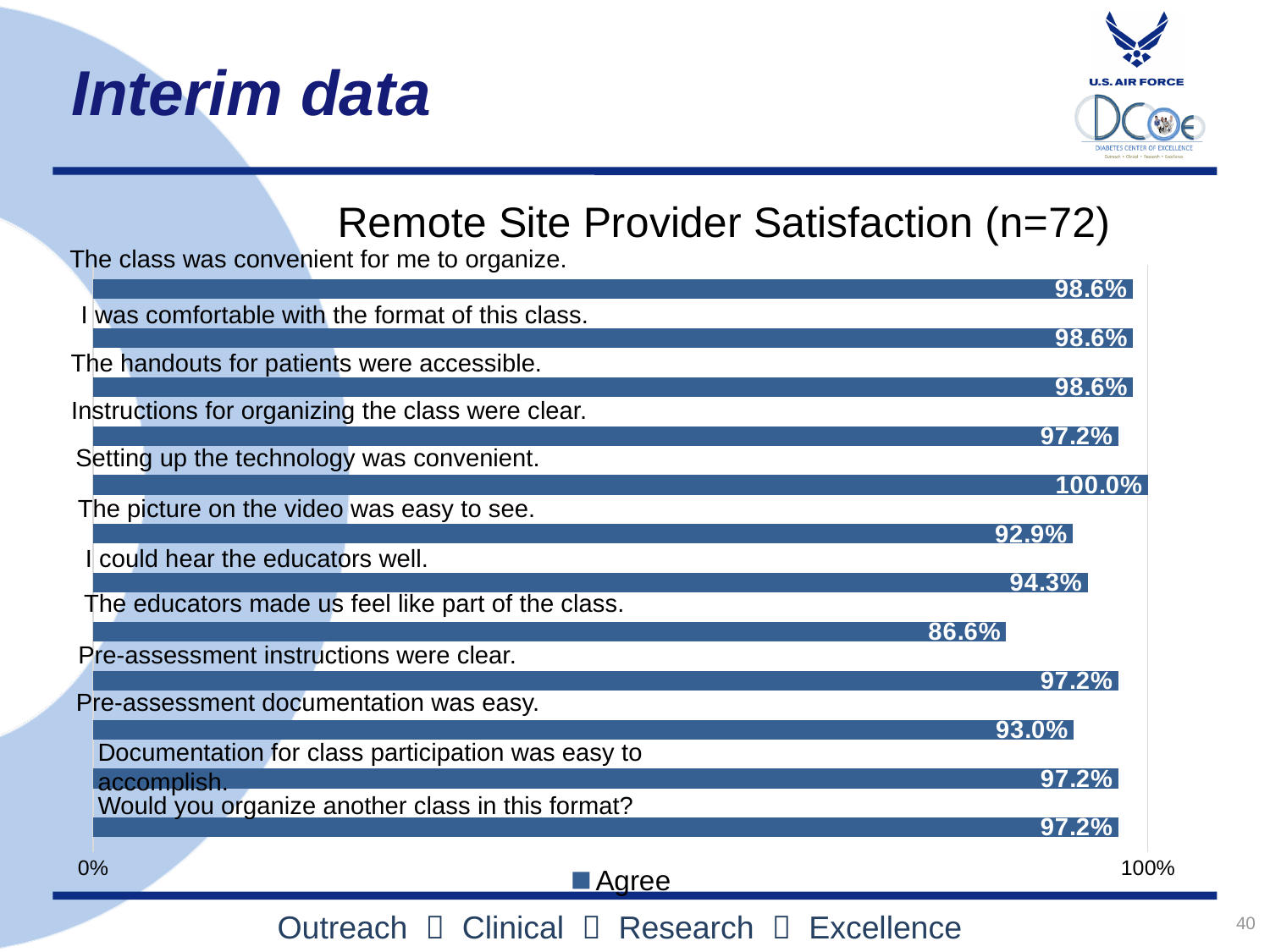
Which statement has the highest agreement percentage? Setting up the technology was convenient. Which has a higher agreement percentage: 'I could hear the educators well.' or 'The picture on the video was easy to see.'? I could hear the educators well. What is the title of the chart? Remote Site Provider Satisfaction (n=72) How many series does the legend list? 1 Which statement has the lowest agreement percentage? The educators made us feel like part of the class. What percentage agreed that 'Setting up the technology was convenient.'? 100.0% How many statements (bars) are shown in the chart? 12 What is the difference between the agreement for 'Setting up the technology was convenient.' and 'The educators made us feel like part of the class.'? 13.4% What percentage agreed that 'The picture on the video was easy to see.'? 92.9% What percentage agreed that 'Pre-assessment documentation was easy.'? 93.0% What kind of chart is shown on the slide? bar chart What percentage agreed that 'The educators made us feel like part of the class.'? 86.6%